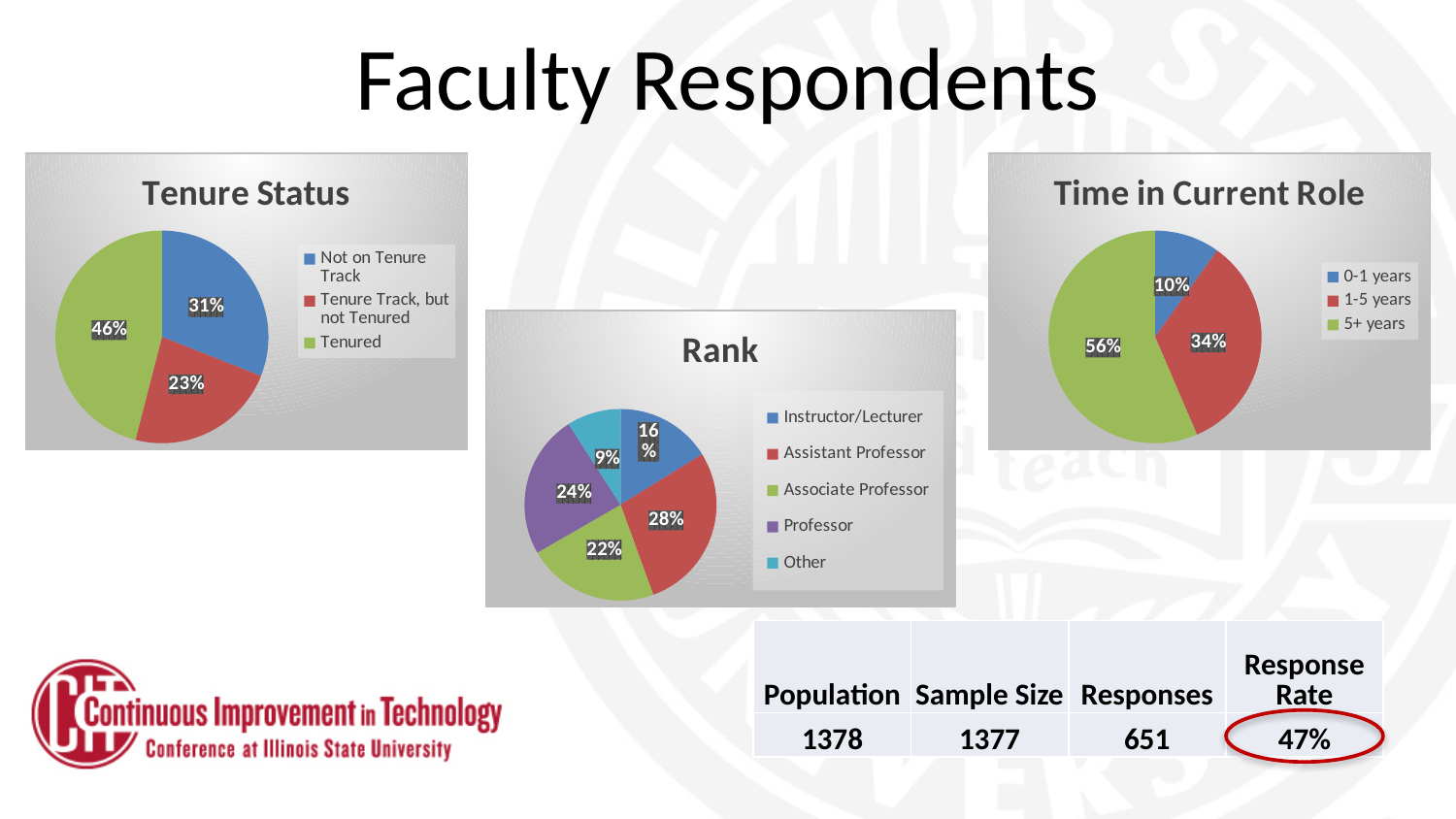
In the Rank chart, which category has the smallest share? Other In the Tenure Status chart, which category has the smallest share? Tenure Track, but not Tenured In the Rank chart, which is larger: Professor or Associate Professor? Professor In the Tenure Status chart, what percentage are Not on Tenure Track? 31% How many categories does the Rank chart's legend list? 5 In the Tenure Status chart, what share of respondents are Tenured? 46% In the Tenure Status chart, what is the difference between the Tenured share and the Not on Tenure Track share? 15% In the Rank chart, which rank has the largest share? Assistant Professor In the Time in Current Role chart, what share of respondents have been in their role 5+ years? 56% What type of chart is the Time in Current Role chart? Pie chart In the Time in Current Role chart, what is the difference between the 1-5 years share and the 0-1 years share? 24% In the Rank chart, what percentage of respondents are Assistant Professors? 28%